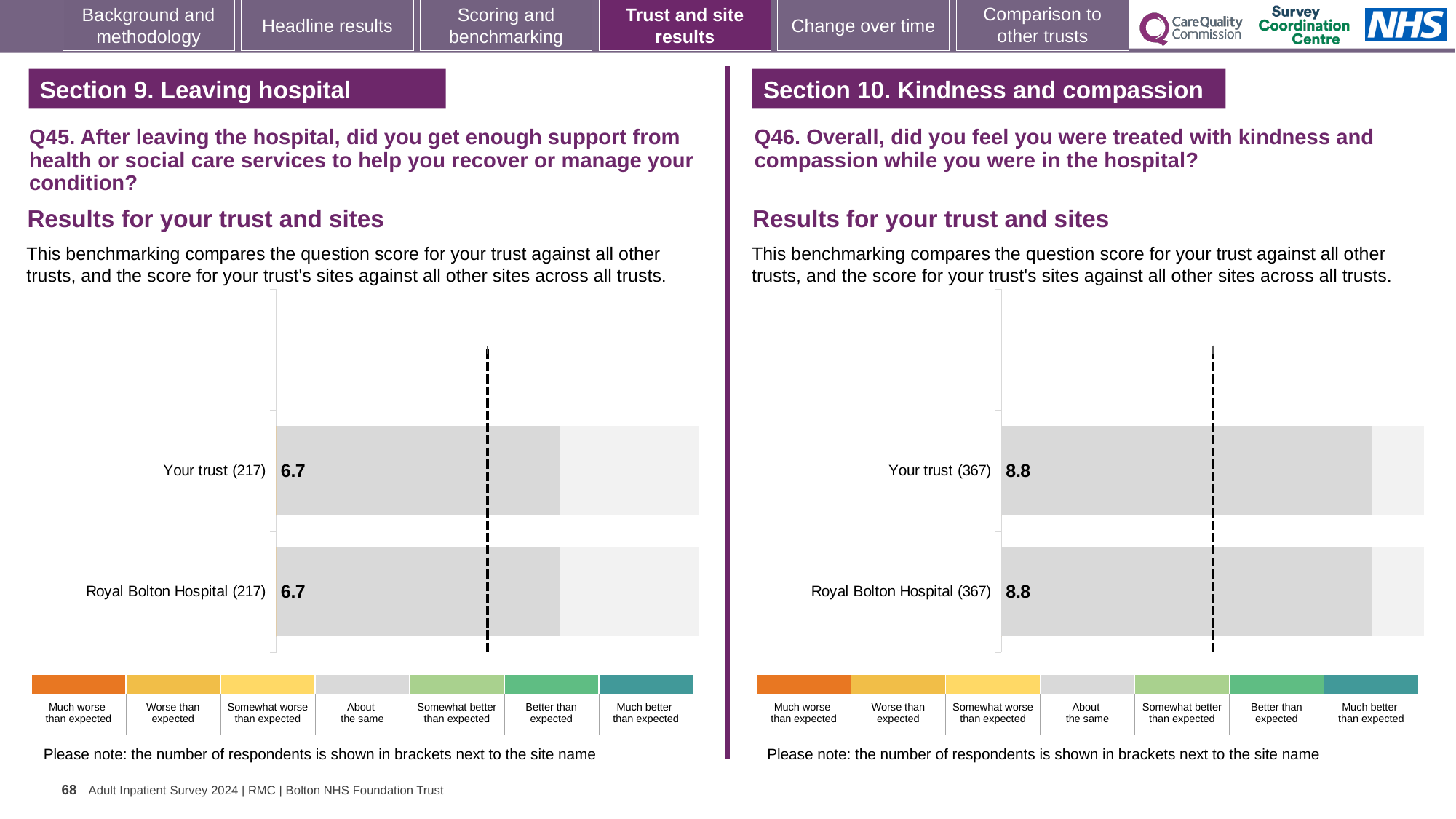
In the Q46 chart on the right, what is the score for Your trust? 8.8 In the Q45 chart on the left, how many respondents are shown in brackets for Royal Bolton Hospital? 217 In the Q46 chart on the right, how many respondents are shown in brackets for Your trust? 367 What kind of chart is used for the Q46 results on the right? Bar chart In the Q45 chart on the left, what is the difference between the score for Your trust and the score for Royal Bolton Hospital? 0 In the Q45 chart on the left, what is the score for Your trust? 6.7 How many bars are plotted in the Q46 chart on the right? 2 In the Q45 chart on the left, what is the score for Royal Bolton Hospital? 6.7 In the Q46 chart on the right, what is the score for Royal Bolton Hospital? 8.8 In the Q46 chart on the right, what is the difference between the score for Your trust and the score for Royal Bolton Hospital? 0 How many bars are plotted in the Q45 chart on the left? 2